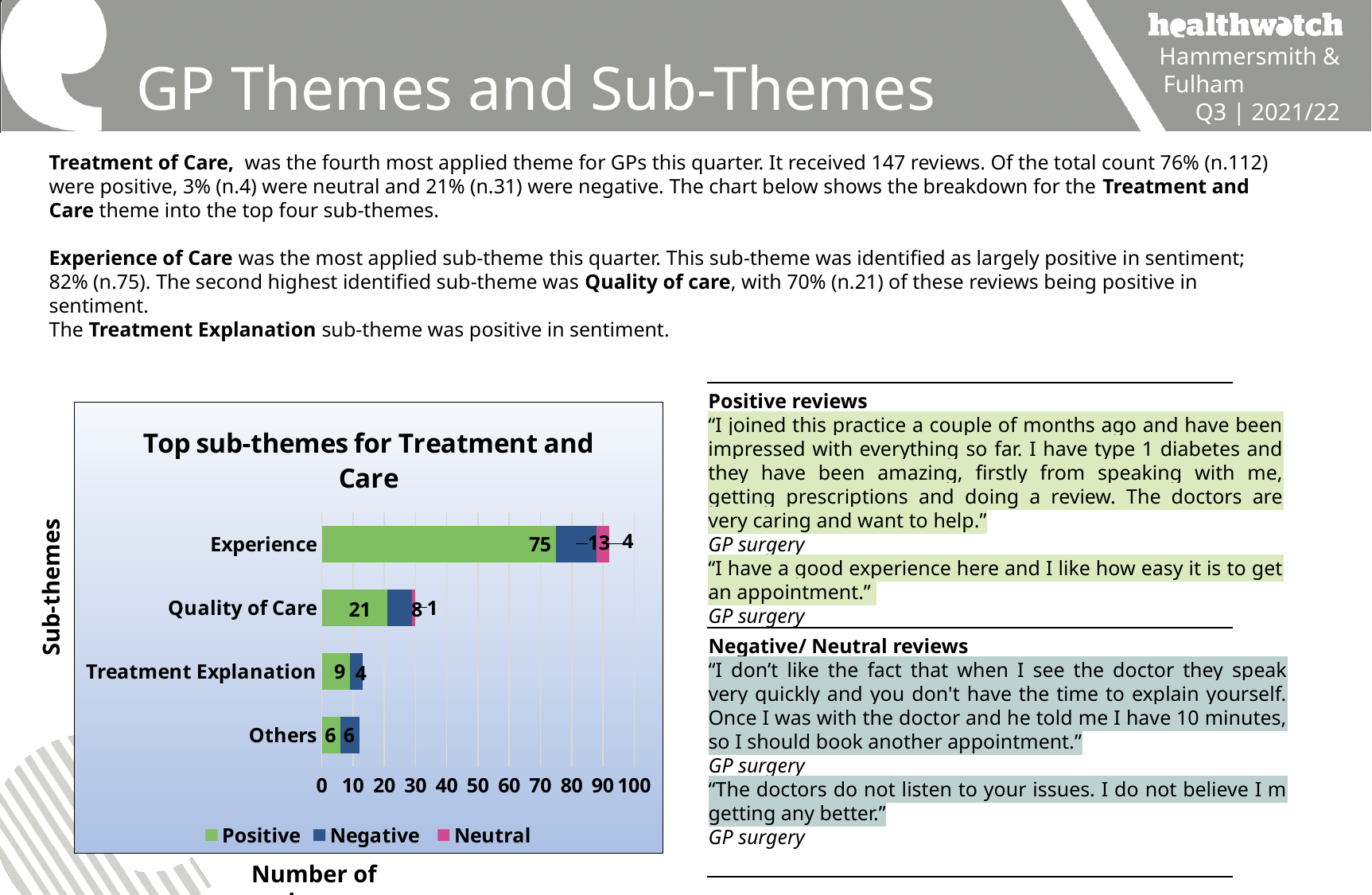
Which sub-theme has the highest Positive value? Experience What is the Neutral value for Experience in the chart? 4 What is the difference between the Positive values for Experience and Quality of Care? 54 How many sub-themes are shown in the chart? 4 Which is larger: the Negative value for Experience or the Negative value for Quality of Care? Experience What type of chart is shown on the slide? Stacked bar chart What is the Negative value for Quality of Care in the chart? 8 What is the total of the stacked bar for Quality of Care? 30 Which sub-theme has the lowest Positive value? Others What is the Negative value for Treatment Explanation in the chart? 4 How many series does the chart legend list? 3 What is the Positive value for Experience in the chart? 75